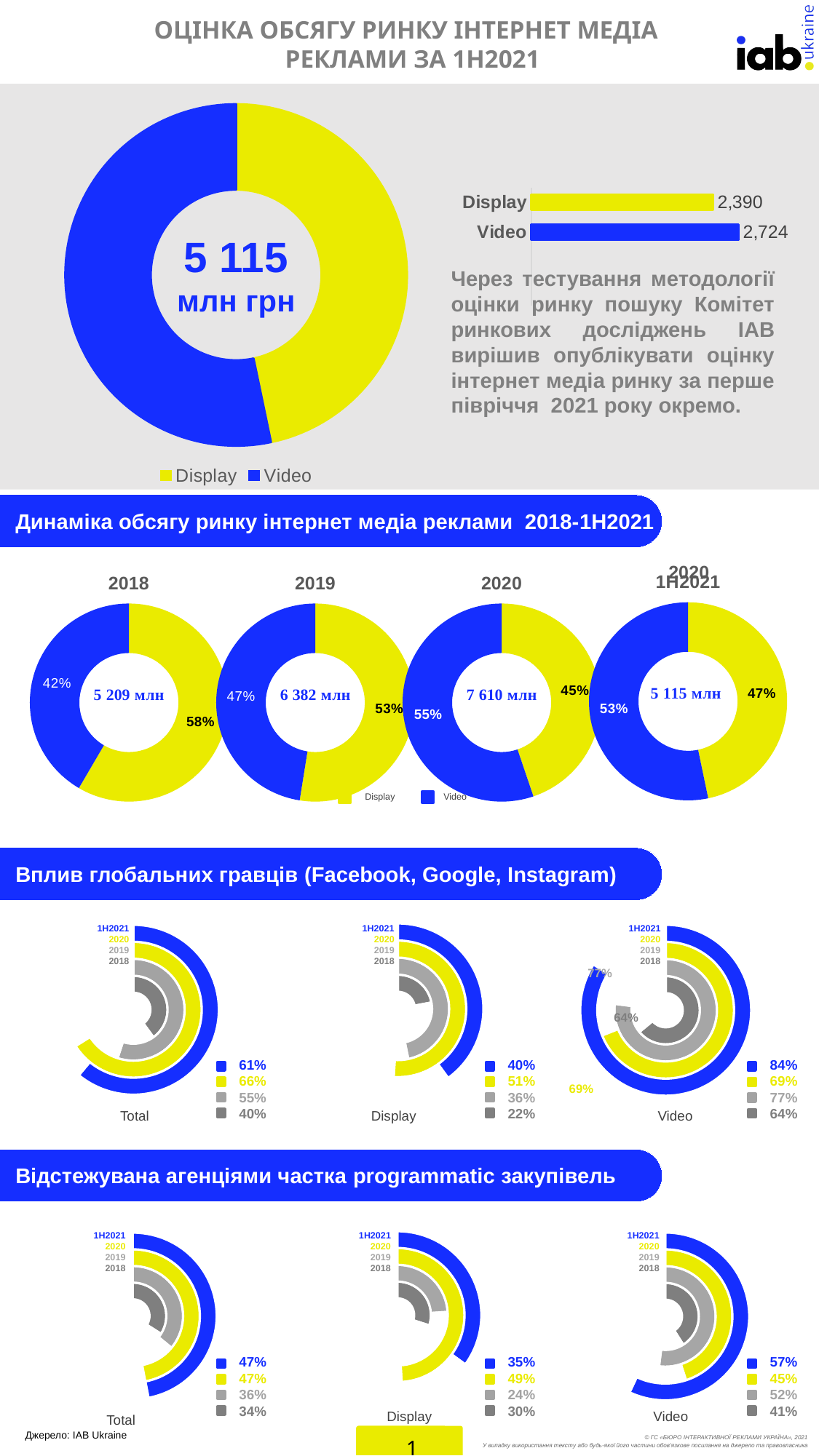
In the bar chart at the top of the slide next to the large donut, what is the value for Display? 2,390 In the 'Динаміка обсягу ринку інтернет медіа реклами 2018-1H2021' section, which year's donut shows the highest market value in its centre? 2020 In the large donut chart at the top of the slide, how many entries does the legend list? 2 In the 'Динаміка обсягу ринку інтернет медіа реклами 2018-1H2021' section, how many donut charts are shown? 4 In the large donut chart at the top of the slide, what total value is shown in the centre? 5 115 млн грн In the 'Вплив глобальних гравців' section, which is larger for 2018: the Display value or the Video value? Video In the 'Відстежувана агенціями частка programmatic закупівель' section, what is the Display value for 2020? 49% In the bar chart at the top of the slide next to the large donut, what is the value for Video? 2,724 In the 'Вплив глобальних гравців' section, what is the Video value for 1H2021? 84% In the 'Динаміка обсягу ринку інтернет медіа реклами 2018-1H2021' section, what share does the yellow (Display) slice have in the 2018 donut? 58% In the bar chart at the top of the slide, what is the difference between the Video and Display values? 334 In the 'Динаміка обсягу ринку інтернет медіа реклами 2018-1H2021' section, what is the market value shown in the centre of the 2020 donut? 7 610 млн